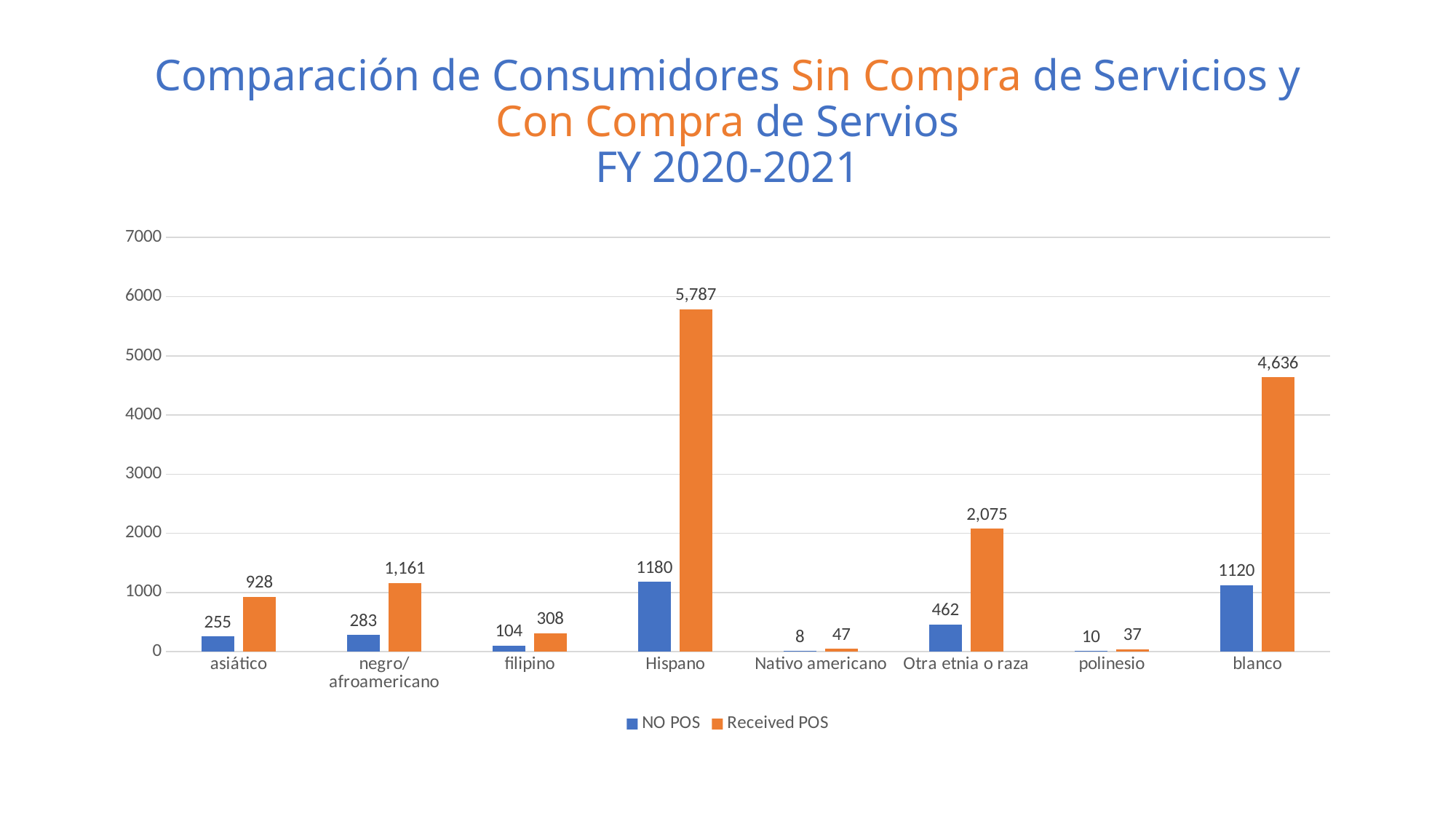
Which is larger, the NO POS value for Hispano or the NO POS value for blanco? Hispano How many series does the legend list? 2 Which colour represents the Received POS series? Orange What is the NO POS value for blanco? 1120 How many categories are shown on the x axis? 8 What kind of chart is shown on the slide? Bar chart What is the NO POS value for asiático? 255 What is the Received POS value for Hispano? 5,787 What is the Received POS value for Otra etnia o raza? 2,075 Which category has the lowest NO POS value? Nativo americano Which category has the highest Received POS value? Hispano What is the difference between the Received POS and NO POS values for blanco? 3,516